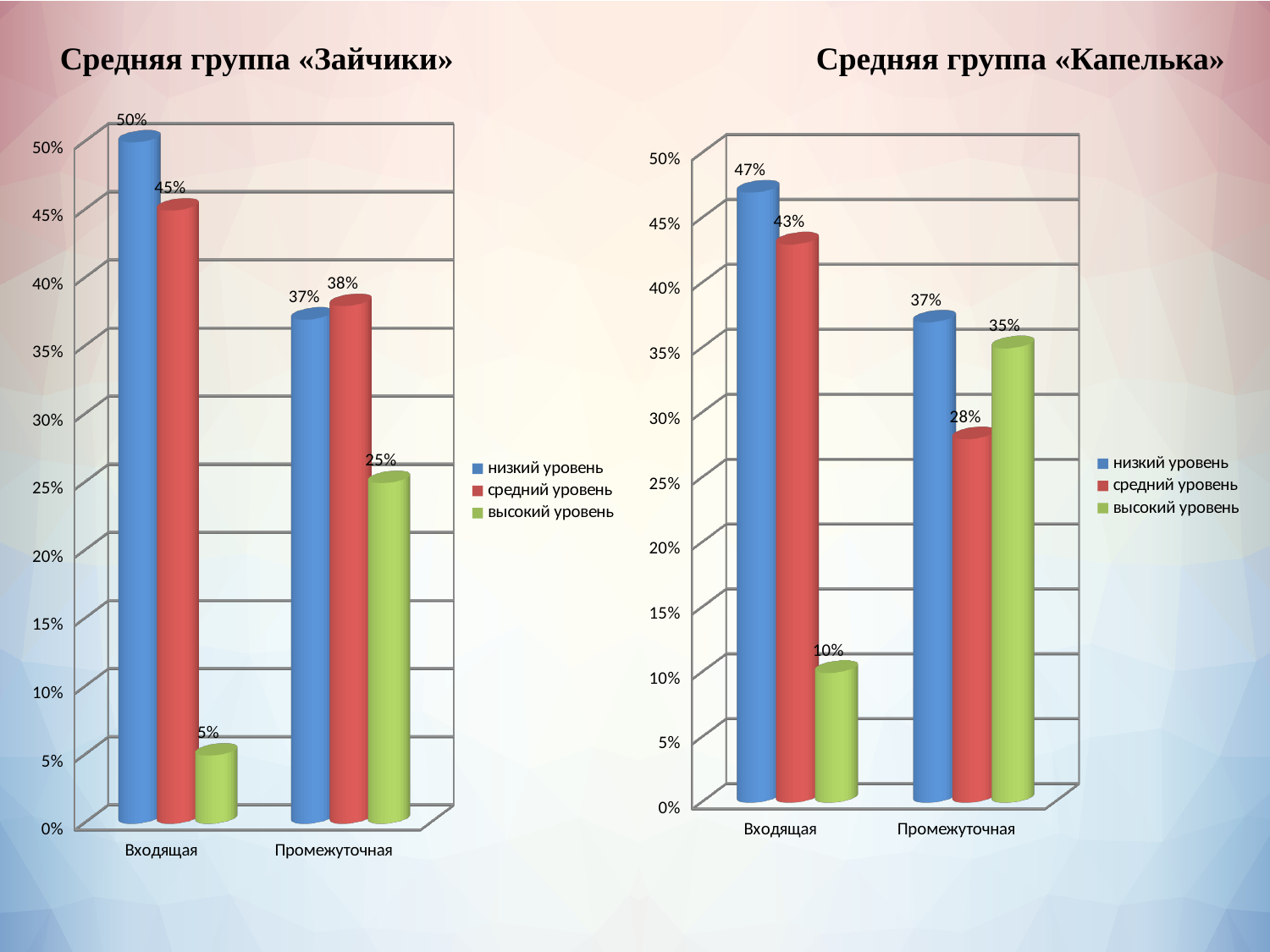
In the «Зайчики» chart (left), what is the value for низкий уровень in the Входящая category? 50% How many series does the legend of the «Зайчики» chart (left) list? 3 What kind of chart is the «Зайчики» chart (left)? bar chart In the «Зайчики» chart (left), what is the value for высокий уровень in the Входящая category? 5% In the «Зайчики» chart (left), which series has the lowest value in the Промежуточная category? высокий уровень In the «Капелька» chart (right), what is the value for средний уровень in the Промежуточная category? 28% In the «Капелька» chart (right), which series has the highest value in the Входящая category? низкий уровень In the «Капелька» chart (right), which is larger in the Промежуточная category: низкий уровень or высокий уровень? низкий уровень In the «Зайчики» chart (left), what is the difference between the высокий уровень values for Промежуточная and Входящая? 20% In the «Капелька» chart (right), what is the difference between the низкий уровень values for Входящая and Промежуточная? 10% How many categories are shown on the x axis of the «Капелька» chart (right)? 2 In the «Капелька» chart (right), what is the value for высокий уровень in the Промежуточная category? 35%